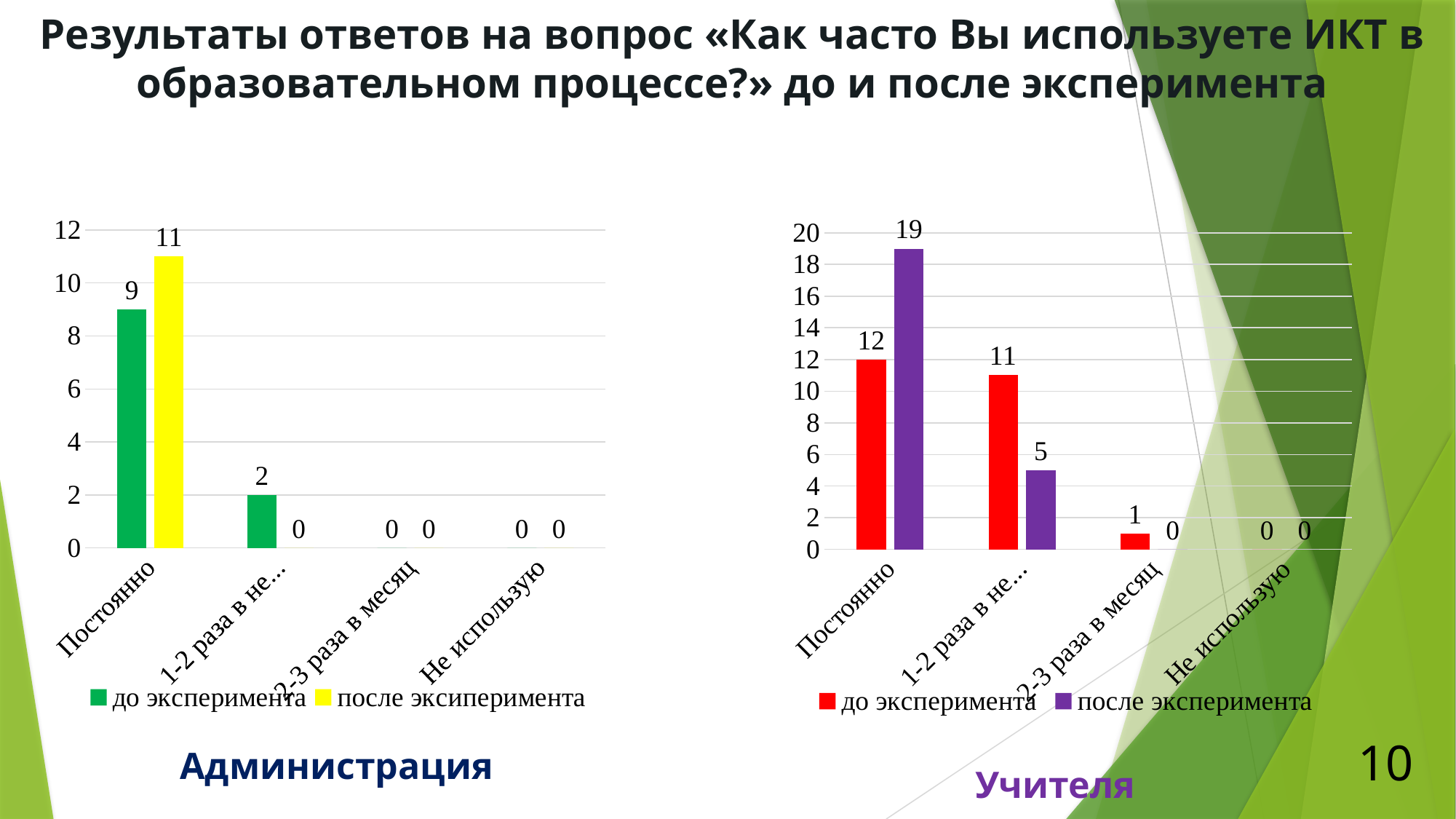
In the Администрация chart, what is the value for Постоянно in the до эксперимента series? 9 In the Учителя chart, which is larger for the category starting with '1-2 раза в не...': до эксперимента or после эксперимента? до эксперимента In the Учителя chart, which category has the highest value in the до эксперимента series? Постоянно How many categories are shown on the x axis of the Администрация chart? 4 In the Учителя chart, what colour represents the после эксперимента series? purple In the Администрация chart, what is the difference between the после эксиперимента and до эксперимента values for Постоянно? 2 What type of chart is the Учителя chart? bar chart In the Учителя chart, what is the value for 2-3 раза в месяц in the до эксперимента series? 1 In the Администрация chart, what is the value for Постоянно in the после эксиперимента series? 11 How many series does the legend of the Учителя chart list? 2 In the Учителя chart, what is the value for Постоянно in the после эксперимента series? 19 In the Учителя chart, what is the difference between the после эксперимента and до эксперимента values for Постоянно? 7